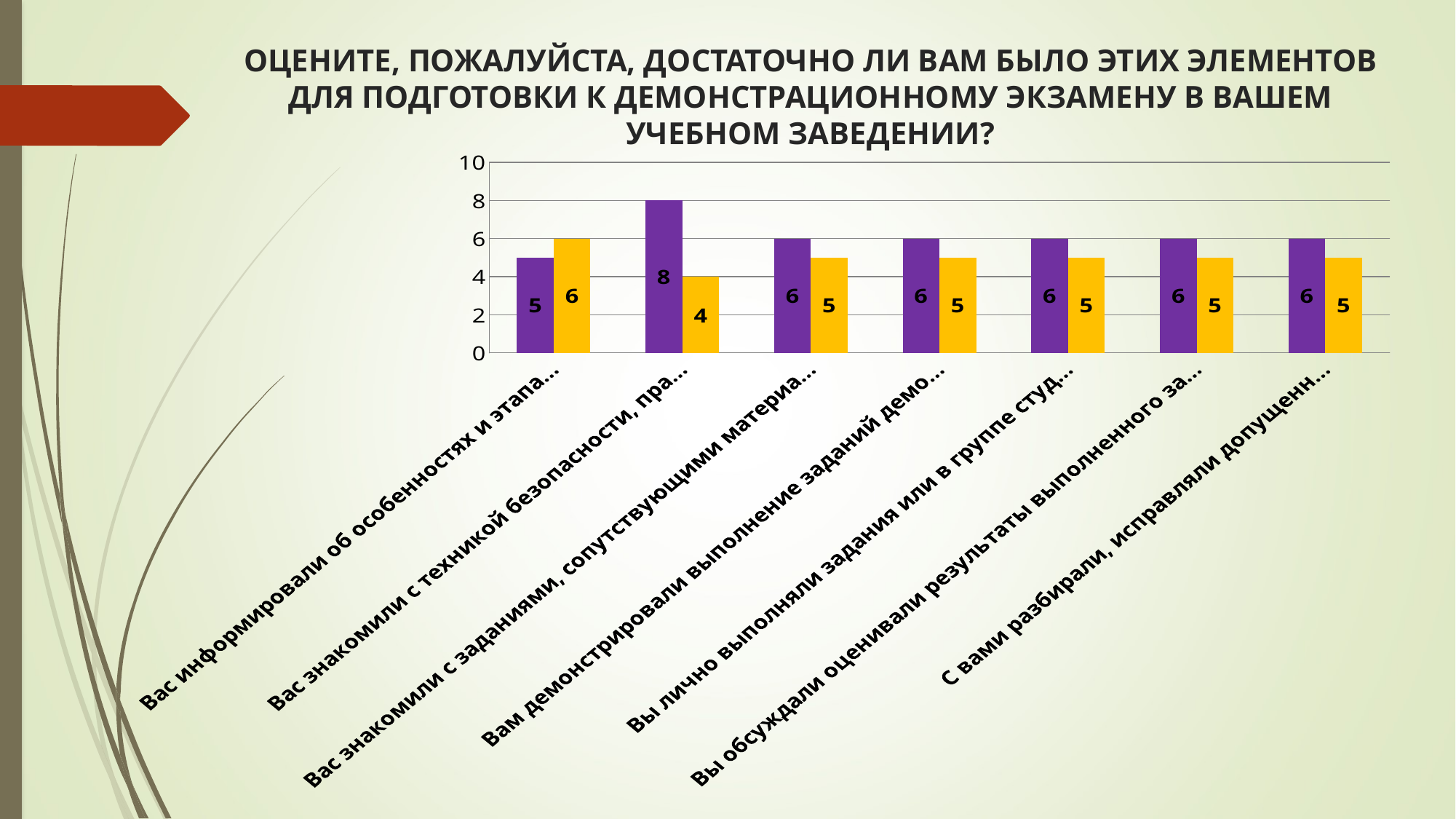
What is the difference between the purple and yellow bars for the category beginning "Вас знакомили с техникой безопасности"? 4 What is the maximum value shown on the vertical axis of the chart? 10 Which category has the lowest yellow bar? Вас знакомили с техникой безопасности, пра... What is the value of the yellow bar for the first category, beginning "Вас информировали об особенностях"? 6 Which category has the highest purple bar? Вас знакомили с техникой безопасности, пра... What is the value of the purple bar for the category beginning "Вас знакомили с техникой безопасности"? 8 What is the value of the yellow bar for the category beginning "Вас знакомили с техникой безопасности"? 4 What is the value of the yellow bar for the last category, beginning "С вами разбирали, исправляли"? 5 How many categories are plotted along the x axis of the chart? 7 For the first category, beginning "Вас информировали об особенностях", which bar is larger, purple or yellow? yellow What kind of chart is shown on the slide? bar chart What is the value of the purple bar for the first category, beginning "Вас информировали об особенностях"? 5